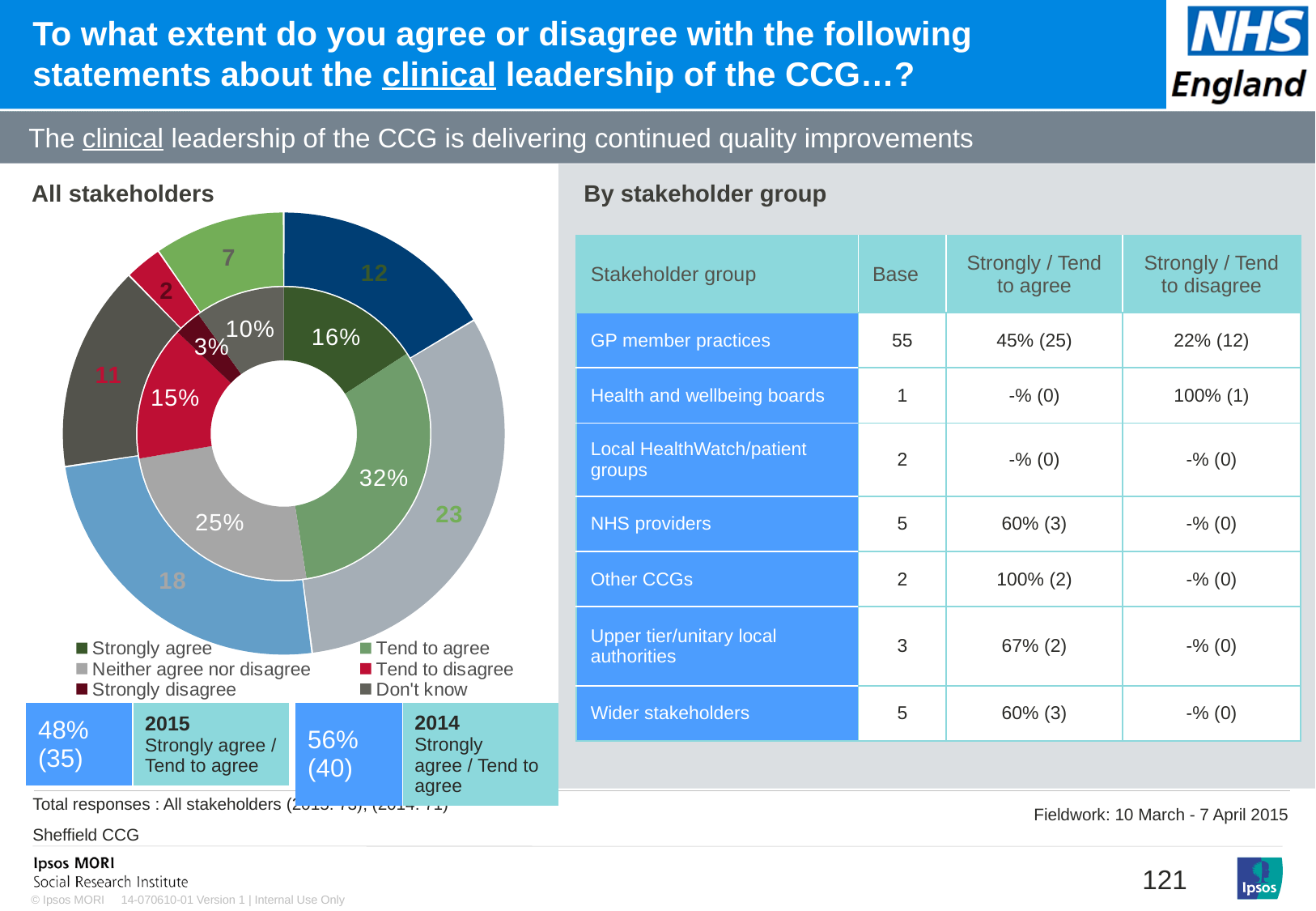
What percentage of all stakeholders neither agree nor disagree? 25% What percentage of all stakeholders tend to disagree? 15% How many response categories does the legend of the 'All stakeholders' chart list? 6 In the 'All stakeholders' chart, which is larger: 'Neither agree nor disagree' or 'Strongly agree'? Neither agree nor disagree Which response category has the smallest share in the 'All stakeholders' chart? Strongly disagree In the 'All stakeholders' chart, what is the difference in percentage points between 'Tend to agree' and 'Tend to disagree'? 17 What percentage of all stakeholders tend to agree? 32% Which response category has the largest share in the 'All stakeholders' chart? Tend to agree What percentage of all stakeholders answered 'Don't know'? 10% What type of chart is used to show the 'All stakeholders' results? Doughnut chart What percentage of all stakeholders strongly agree that the clinical leadership of the CCG is delivering continued quality improvements? 16% In the 'All stakeholders' chart, what is the combined percentage of 'Strongly agree' and 'Tend to agree'? 48%